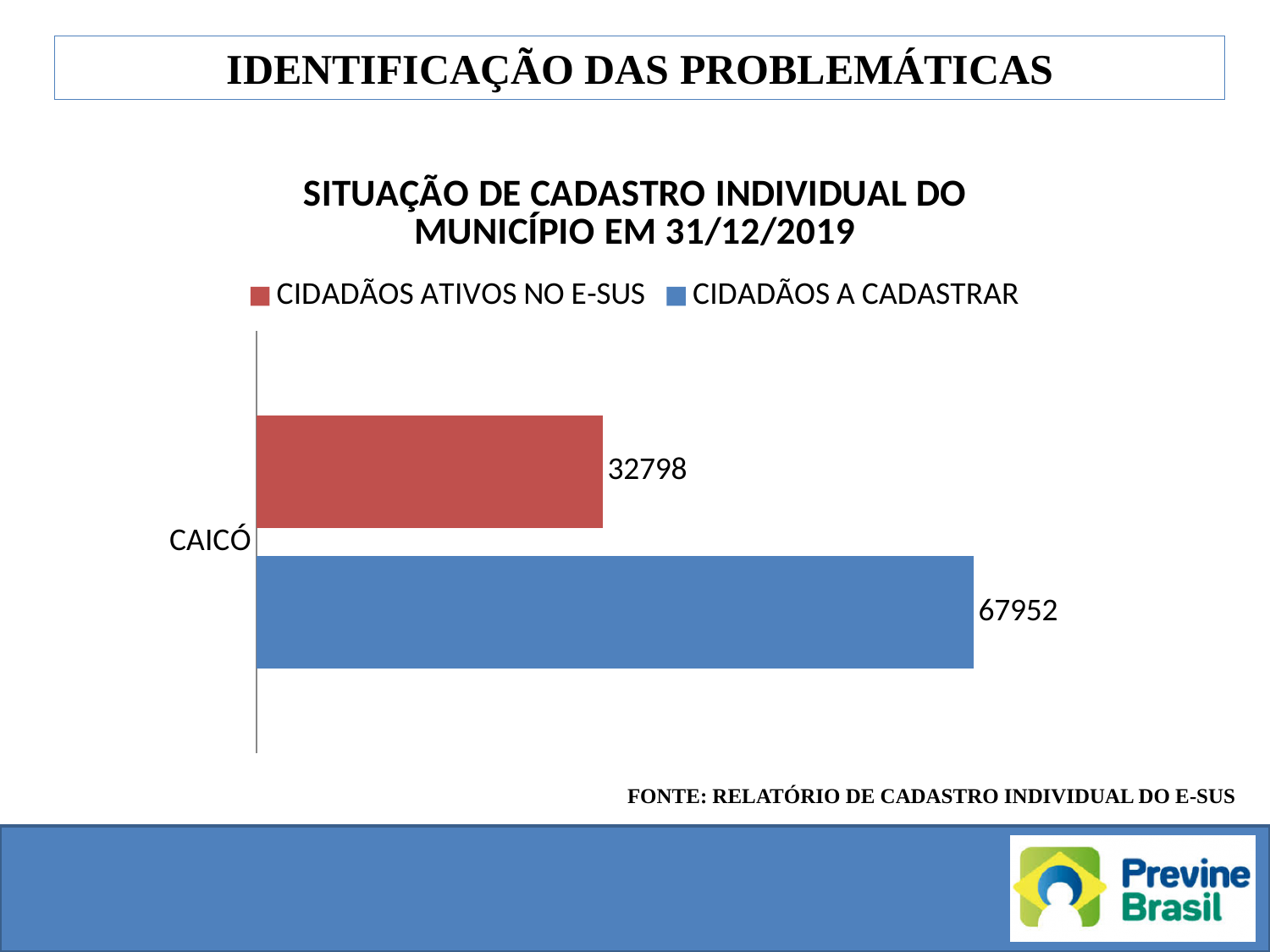
Which series has the lower value for CAICÓ? CIDADÃOS ATIVOS NO E-SUS What is the value for CIDADÃOS A CADASTRAR for CAICÓ? 67952 What kind of chart is shown on the slide? bar chart What is the difference between CIDADÃOS A CADASTRAR and CIDADÃOS ATIVOS NO E-SUS for CAICÓ? 35154 How many categories are shown on the chart? 1 How many series does the legend list? 2 What is the title of the chart? SITUAÇÃO DE CADASTRO INDIVIDUAL DO MUNICÍPIO EM 31/12/2019 Which colour represents CIDADÃOS A CADASTRAR in the chart? blue Which series has the higher value for CAICÓ? CIDADÃOS A CADASTRAR Is the value for CIDADÃOS ATIVOS NO E-SUS larger or smaller than the value for CIDADÃOS A CADASTRAR? smaller What is the value for CIDADÃOS ATIVOS NO E-SUS for CAICÓ? 32798 What is the sum of the two values shown for CAICÓ? 100750